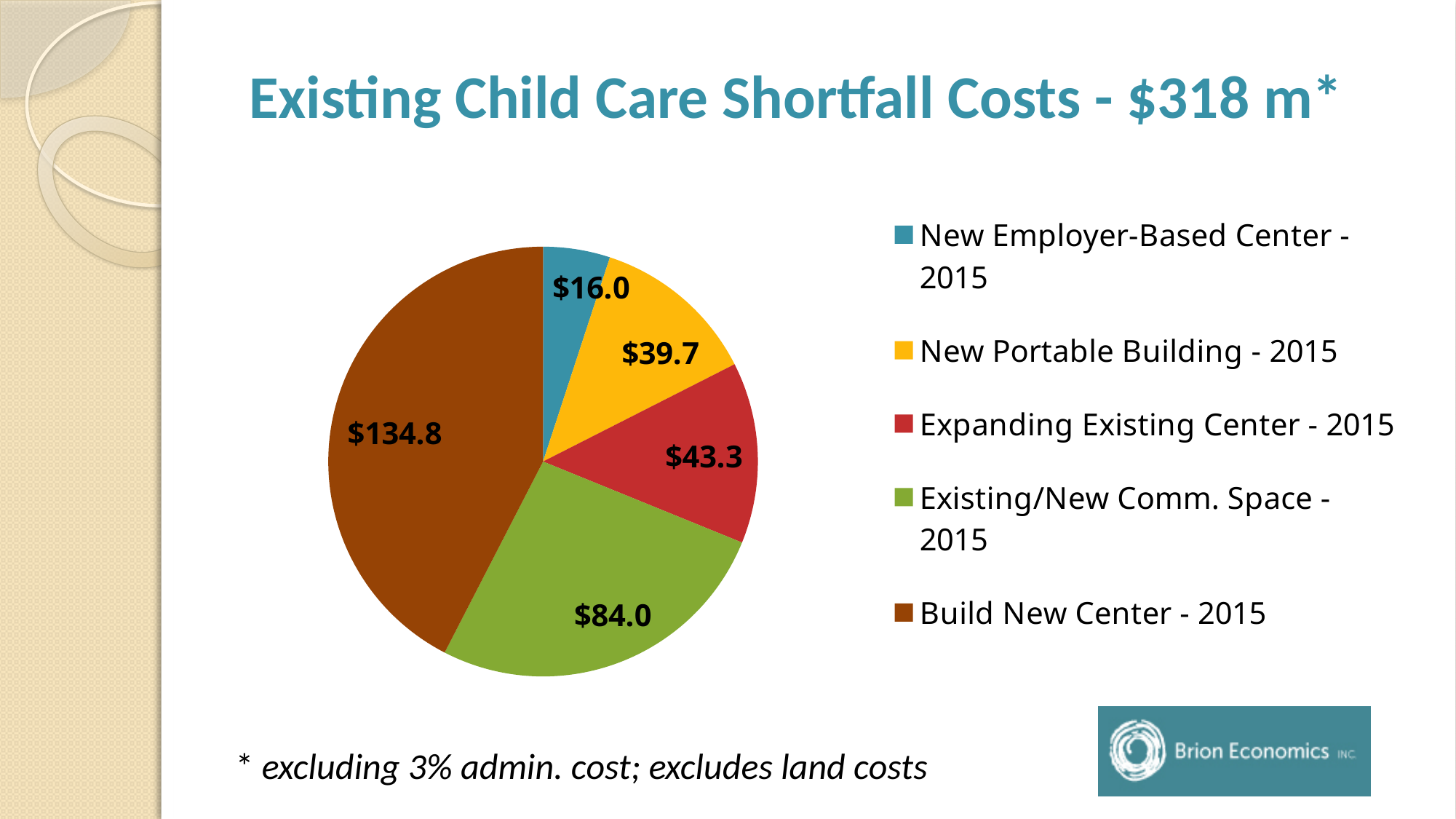
What colour is the slice for Existing/New Comm. Space - 2015? Green Which is larger, the value for Expanding Existing Center - 2015 or New Portable Building - 2015? Expanding Existing Center - 2015 What is the value for Build New Center - 2015? $134.8 Which category has the smallest slice of the pie? New Employer-Based Center - 2015 What is the value for New Portable Building - 2015? $39.7 What is the value for Existing/New Comm. Space - 2015? $84.0 What type of chart is shown on the slide? Pie chart What is the difference between the values for Build New Center - 2015 and Existing/New Comm. Space - 2015? $50.8 How many categories does the pie chart show? 5 What is the title of the slide? Existing Child Care Shortfall Costs - $318 m* What is the difference between the values for Expanding Existing Center - 2015 and New Portable Building - 2015? $3.6 Which category has the largest slice of the pie? Build New Center - 2015